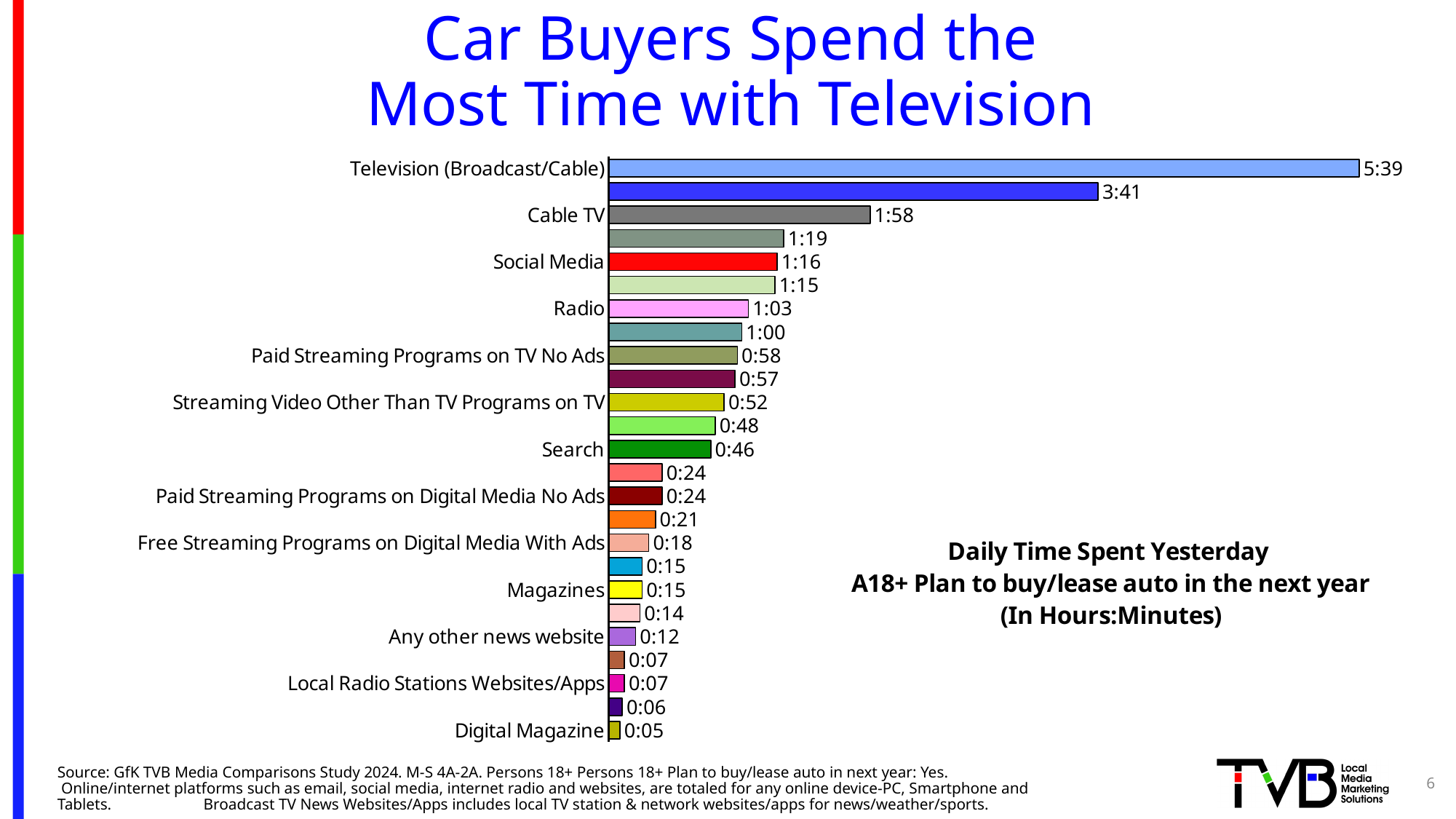
In what units are the values on the chart expressed? Hours:Minutes What is the daily time spent with Television (Broadcast/Cable)? 5:39 What is the value shown for Digital Magazine? 0:05 Which labeled category has the lowest daily time spent? Digital Magazine Which is larger, the value for Radio or the value for Paid Streaming Programs on TV No Ads? Radio What is the value shown for Search? 0:46 What is the difference between Television (Broadcast/Cable) and Cable TV? 3:41 What is the difference between Social Media and Radio? 0:13 Which category has the highest daily time spent? Television (Broadcast/Cable) What kind of chart is shown on the slide? Bar chart What is the value shown for Cable TV? 1:58 What is the value shown for Social Media? 1:16